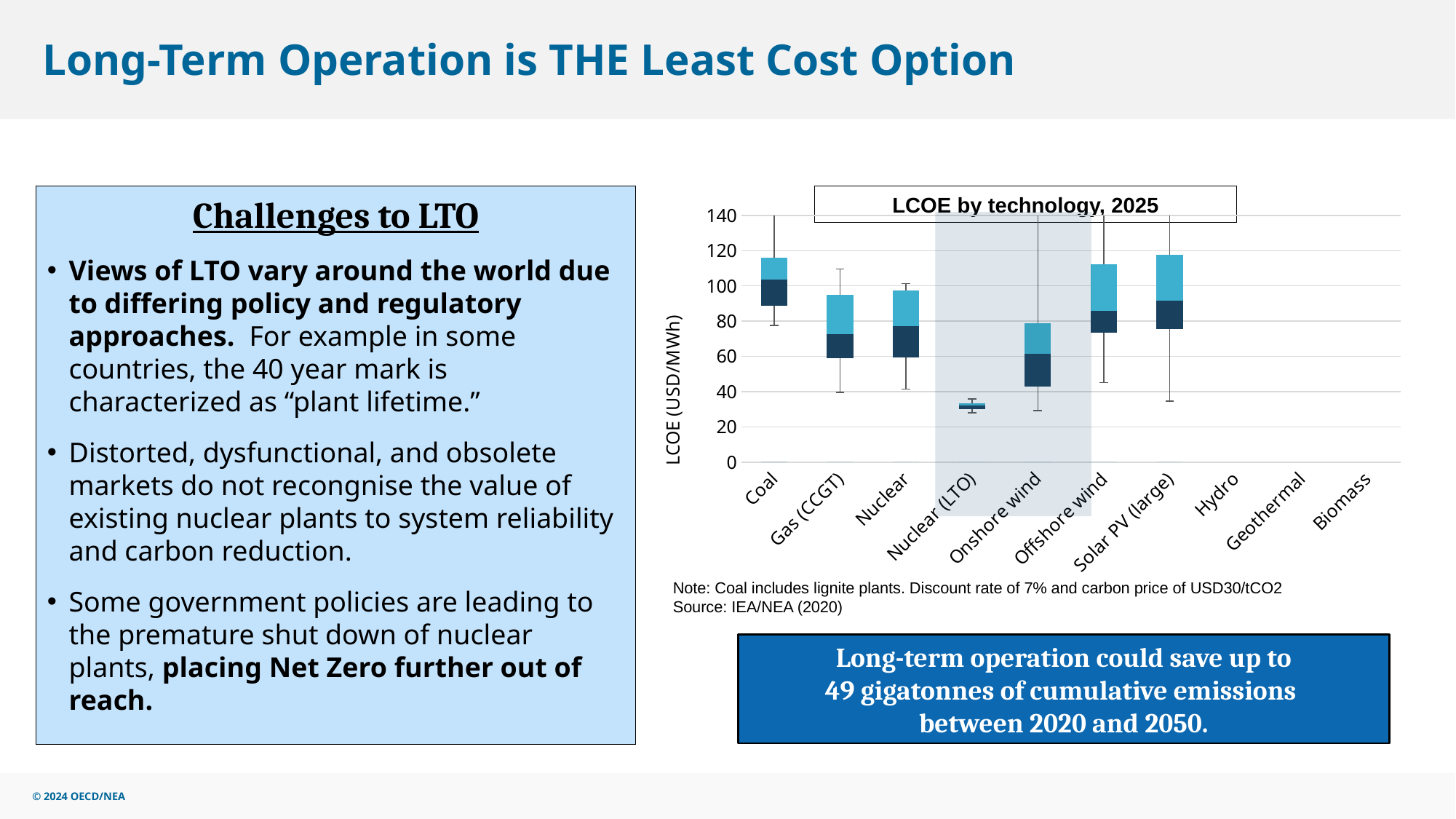
Is the LCOE value for Nuclear (LTO) greater or less than 40 USD/MWh? less Which has the higher median LCOE, Coal or Nuclear (LTO)? Coal Which has the higher median LCOE, Offshore wind or Onshore wind? Offshore wind What is the title of the chart on the slide? LCOE by technology, 2025 Is the median LCOE for Coal greater or less than 80 USD/MWh? greater What is the label of the vertical axis of the chart? LCOE (USD/MWh) Is the median LCOE for Solar PV (large) greater or less than 60 USD/MWh? greater What is the highest value shown on the vertical axis of the chart? 140 Which technology has the lowest LCOE in the chart? Nuclear (LTO) What kind of chart is shown on the slide? Box-and-whisker (box plot) chart How many technology categories are labelled on the x axis of the chart? 10